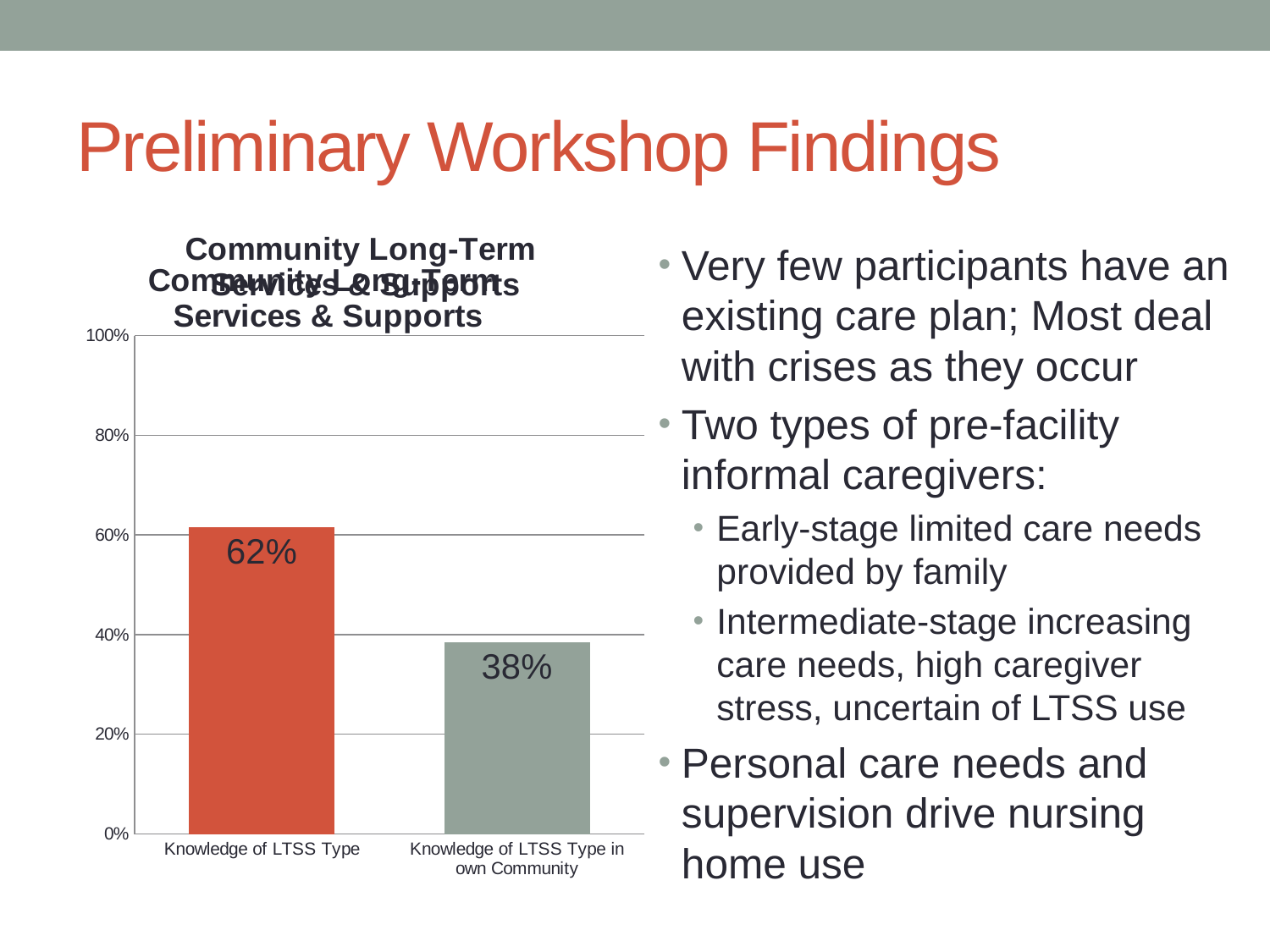
Which category has the highest value? Knowledge of LTSS Type What kind of chart is shown on the slide? Bar chart Is the value for Knowledge of LTSS Type greater or less than 60%? greater Which category has the lowest value? Knowledge of LTSS Type in own Community What is the title of the chart? Community Long-Term Services & Supports What is the difference between the values for Knowledge of LTSS Type and Knowledge of LTSS Type in own Community? 24% Which is larger: the value for Knowledge of LTSS Type or the value for Knowledge of LTSS Type in own Community? Knowledge of LTSS Type What is the value for Knowledge of LTSS Type in own Community? 38% Is the value for Knowledge of LTSS Type in own Community greater or less than 40%? less What is the value for Knowledge of LTSS Type? 62% How many categories are shown on the chart? 2 What is the highest value shown on the vertical axis of the chart? 100%